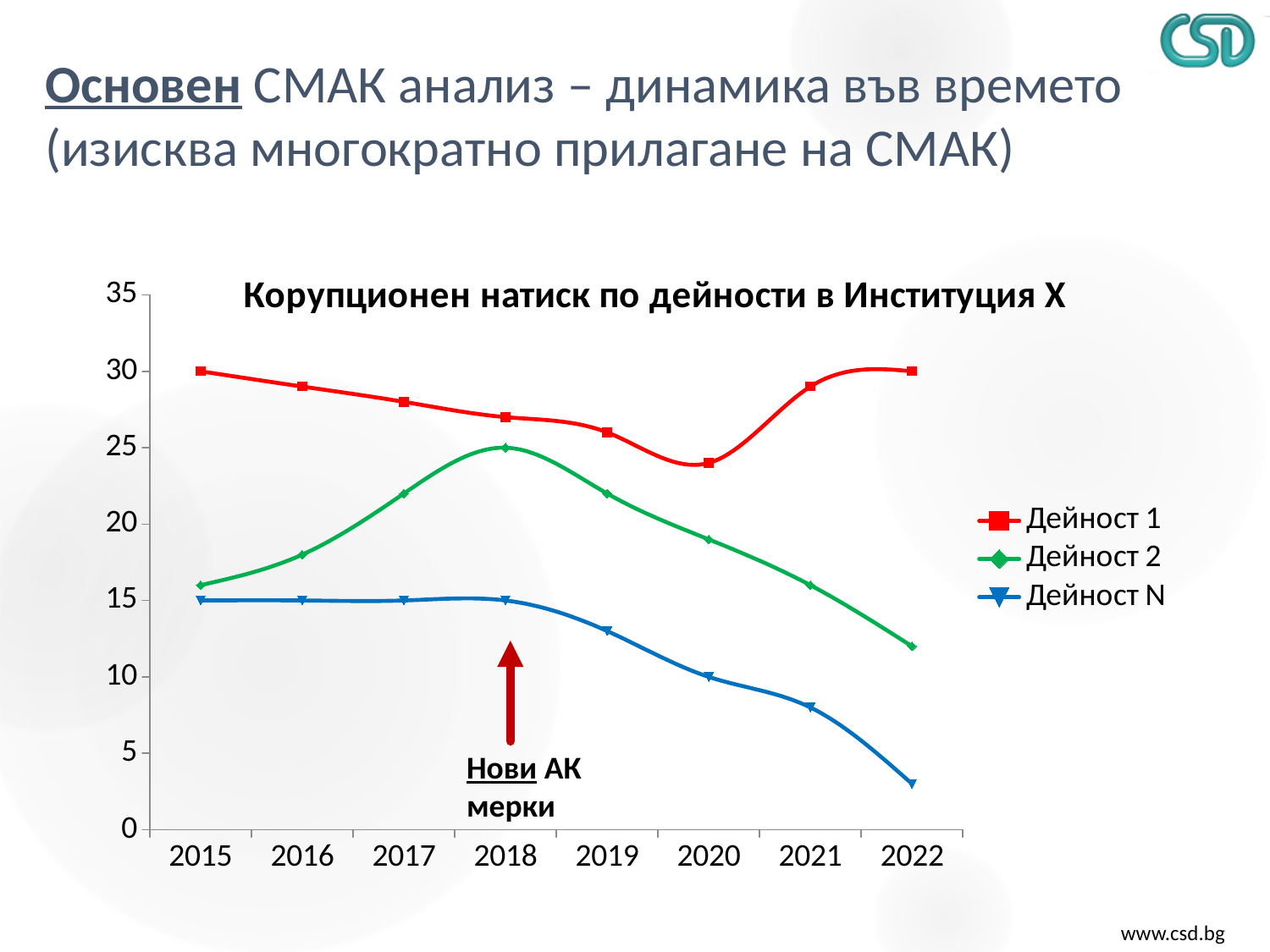
Which series has the highest value in 2022? Дейност 1 How many years are shown on the x axis? 8 What is the title of the chart? Корупционен натиск по дейности в Институция Х What is the value for Дейност 2 in 2018? 25 Does the value for Дейност N rise or fall from 2018 to 2022? fall Is the value for Дейност N in 2022 greater or less than 5? less What is the value for Дейност 1 in 2015? 30 What is the value for Дейност N in 2020? 10 How many series does the legend list? 3 Is the value for Дейност 1 in 2020 greater or less than 20? greater What is the value for Дейност N in 2015? 15 What kind of chart is shown on the slide? line chart